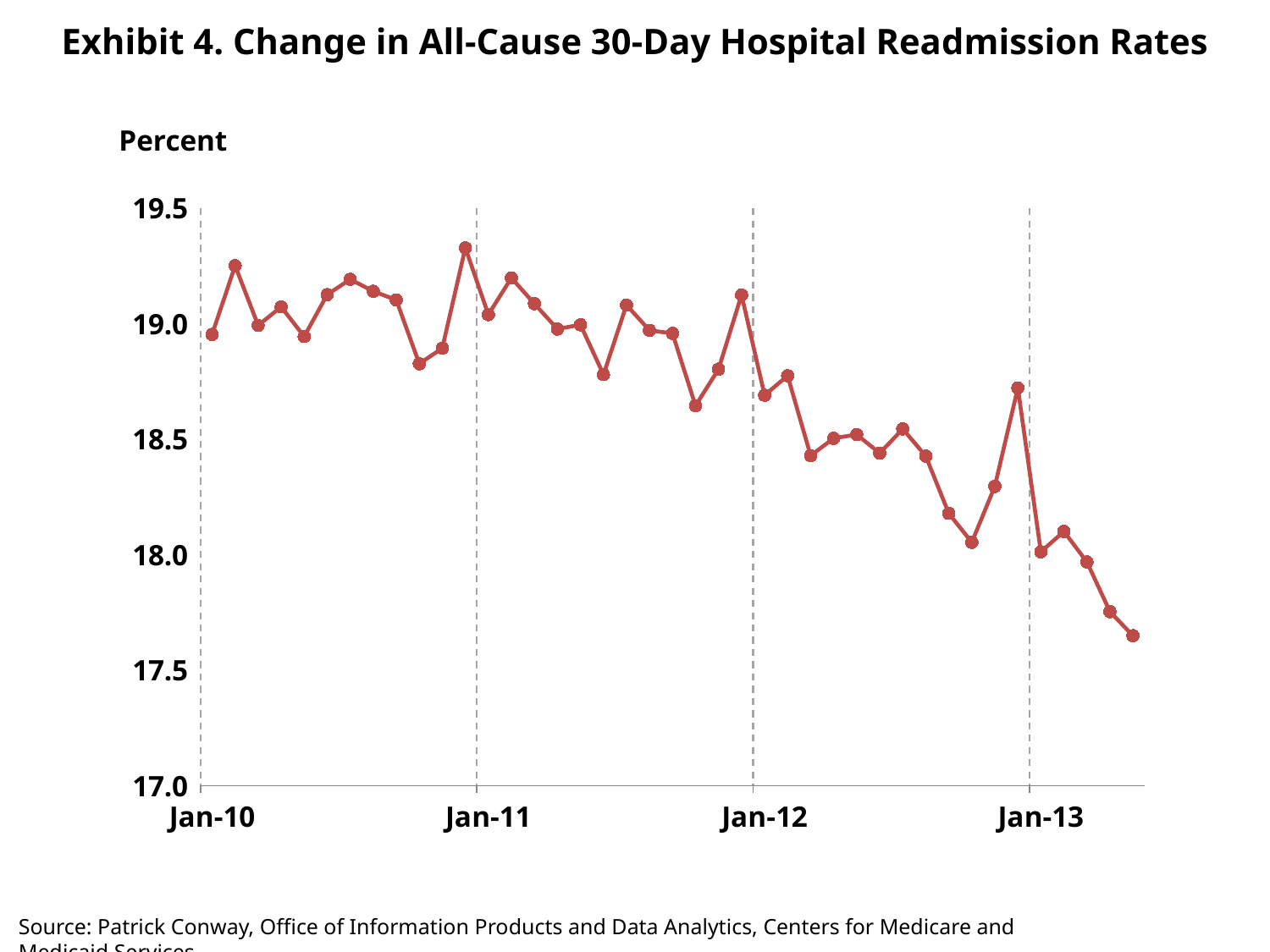
What is the title of the chart? Exhibit 4. Change in All-Cause 30-Day Hospital Readmission Rates Is the final plotted value on the chart greater or less than 18.0? less What kind of chart is shown on the slide? Line chart Is the value at Jan-12 greater or less than 19.0? less Which is higher, the value at Jan-10 or the value at Jan-13? Jan-10 Is the value at Jan-10 greater or less than 18.5? greater Overall, do the readmission rates rise or fall from Jan-10 to the end of the series? Fall What unit is the vertical axis labelled with? Percent Which is higher, the value at Jan-12 or the value at Jan-13? Jan-12 How many data series (lines) are plotted on the chart? 1 Does the lowest point on the chart occur before or after Jan-13? After